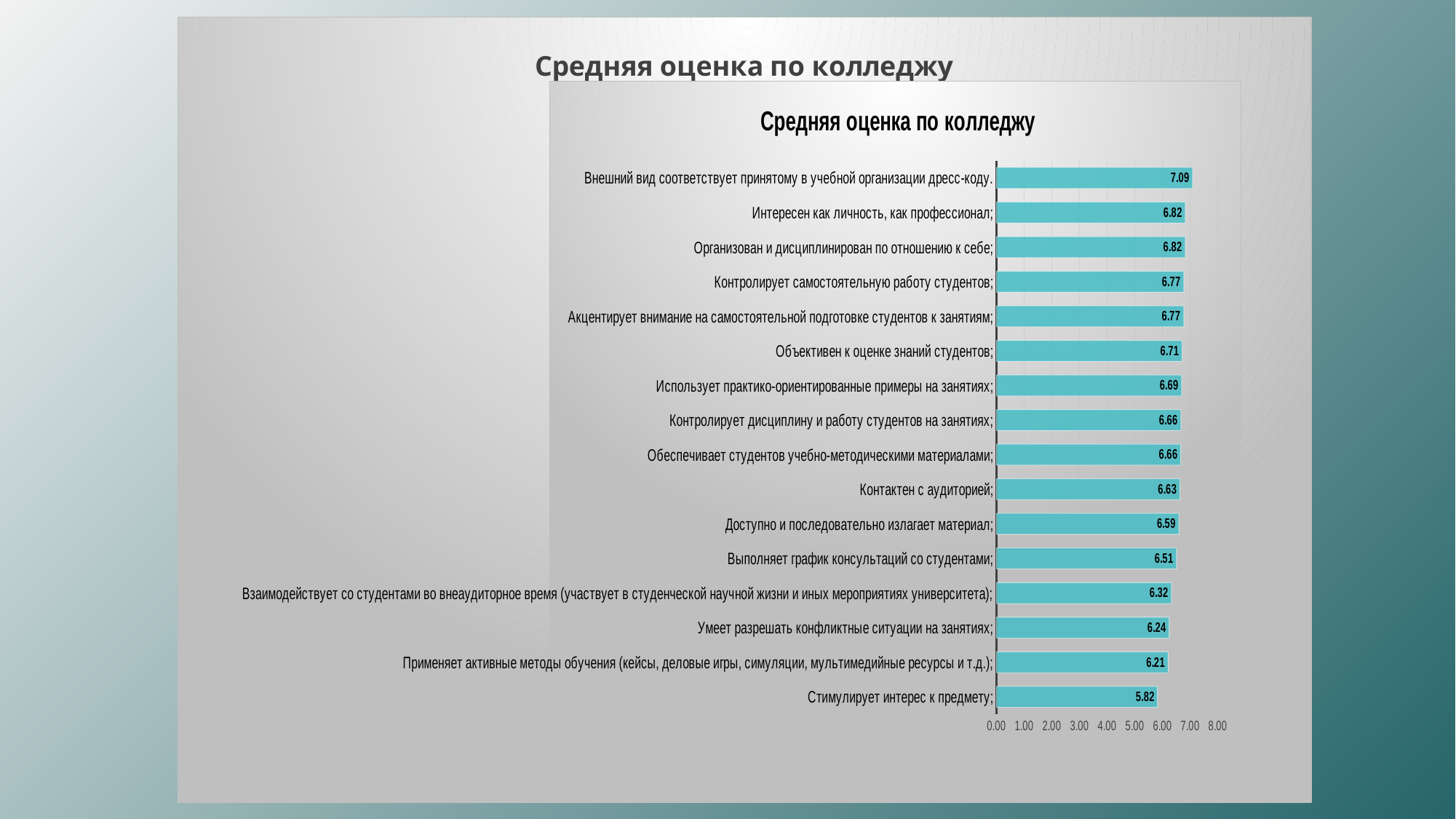
How many categories are plotted in the chart? 16 Is the value for "Стимулирует интерес к предмету" greater or less than 6.00? less Which category has the highest value? Внешний вид соответствует принятому в учебной организации дресс-коду What type of chart is shown on the slide? Bar chart What is the difference between the highest value (7.09) and the lowest value (5.82)? 1.27 What is the value for "Стимулирует интерес к предмету"? 5.82 What is the value for "Умеет разрешать конфликтные ситуации на занятиях"? 6.24 Which category has the lowest value? Стимулирует интерес к предмету What is the value for "Внешний вид соответствует принятому в учебной организации дресс-коду"? 7.09 Which is larger: the value for "Контактен с аудиторией" or the value for "Выполняет график консультаций со студентами"? Контактен с аудиторией What is the title of the chart? Средняя оценка по колледжу What is the value for "Контактен с аудиторией"? 6.63